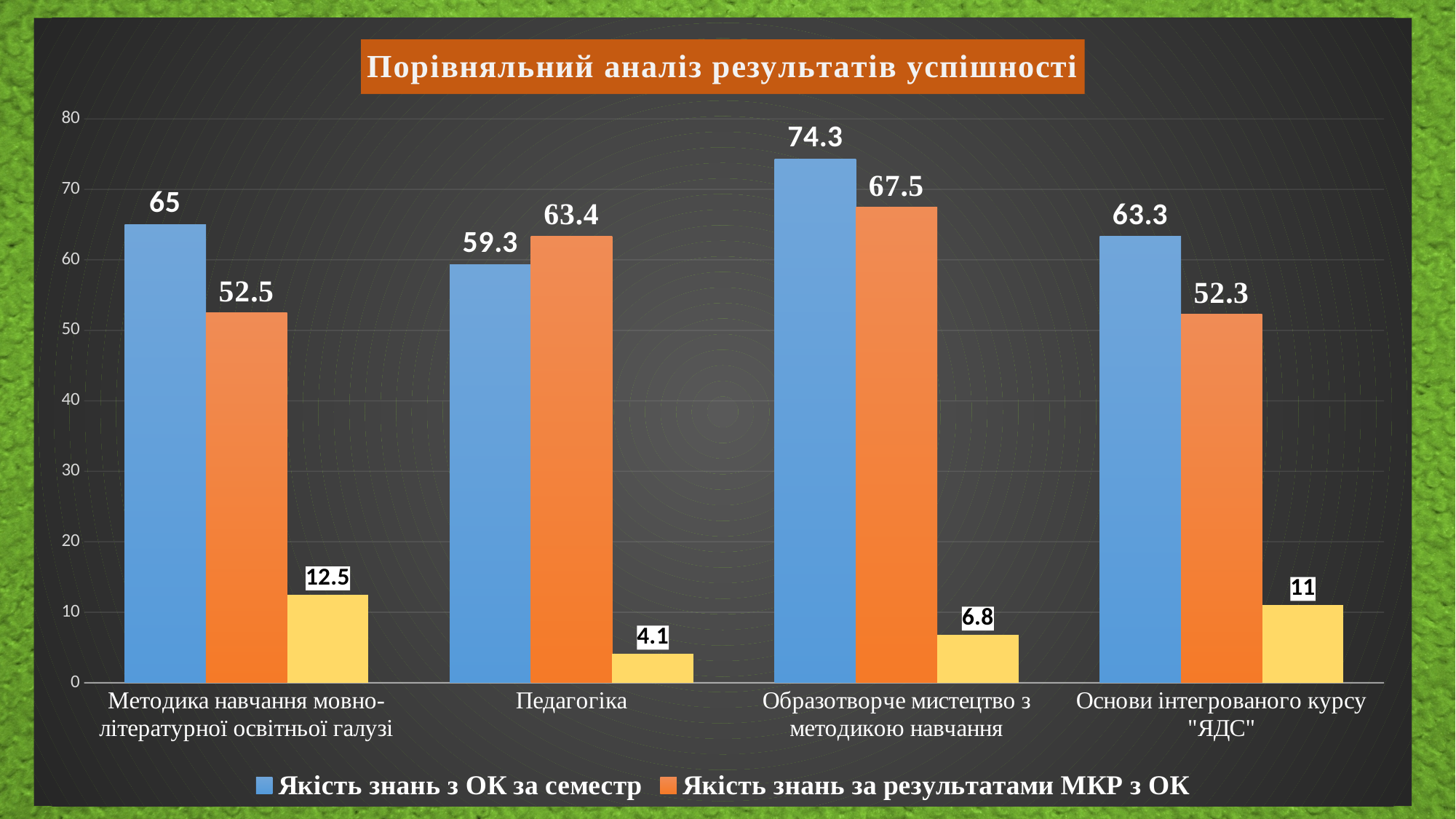
How many series does the legend list? 2 What is the value of "Якість знань з ОК за семестр" for Педагогіка? 59.3 What type of chart is shown on the slide? bar chart Which category has the highest value for "Якість знань з ОК за семестр"? Образотворче мистецтво з методикою навчання What is the difference between "Якість знань з ОК за семестр" and "Якість знань за результатами МКР з ОК" for Образотворче мистецтво з методикою навчання? 6.8 How many categories are shown on the x axis? 4 Which category has the lowest value for "Якість знань за результатами МКР з ОК"? Основи інтегрованого курсу "ЯДС" For Педагогіка, which is larger: "Якість знань з ОК за семестр" or "Якість знань за результатами МКР з ОК"? Якість знань за результатами МКР з ОК What is the title of the chart? Порівняльний аналіз результатів успішності What is the value of "Якість знань за результатами МКР з ОК" for Основи інтегрованого курсу "ЯДС"? 52.3 Is the value of "Якість знань з ОК за семестр" for Образотворче мистецтво з методикою навчання greater or less than 70? greater What is the value of "Якість знань за результатами МКР з ОК" for Методика навчання мовно-літературної освітньої галузі? 52.5